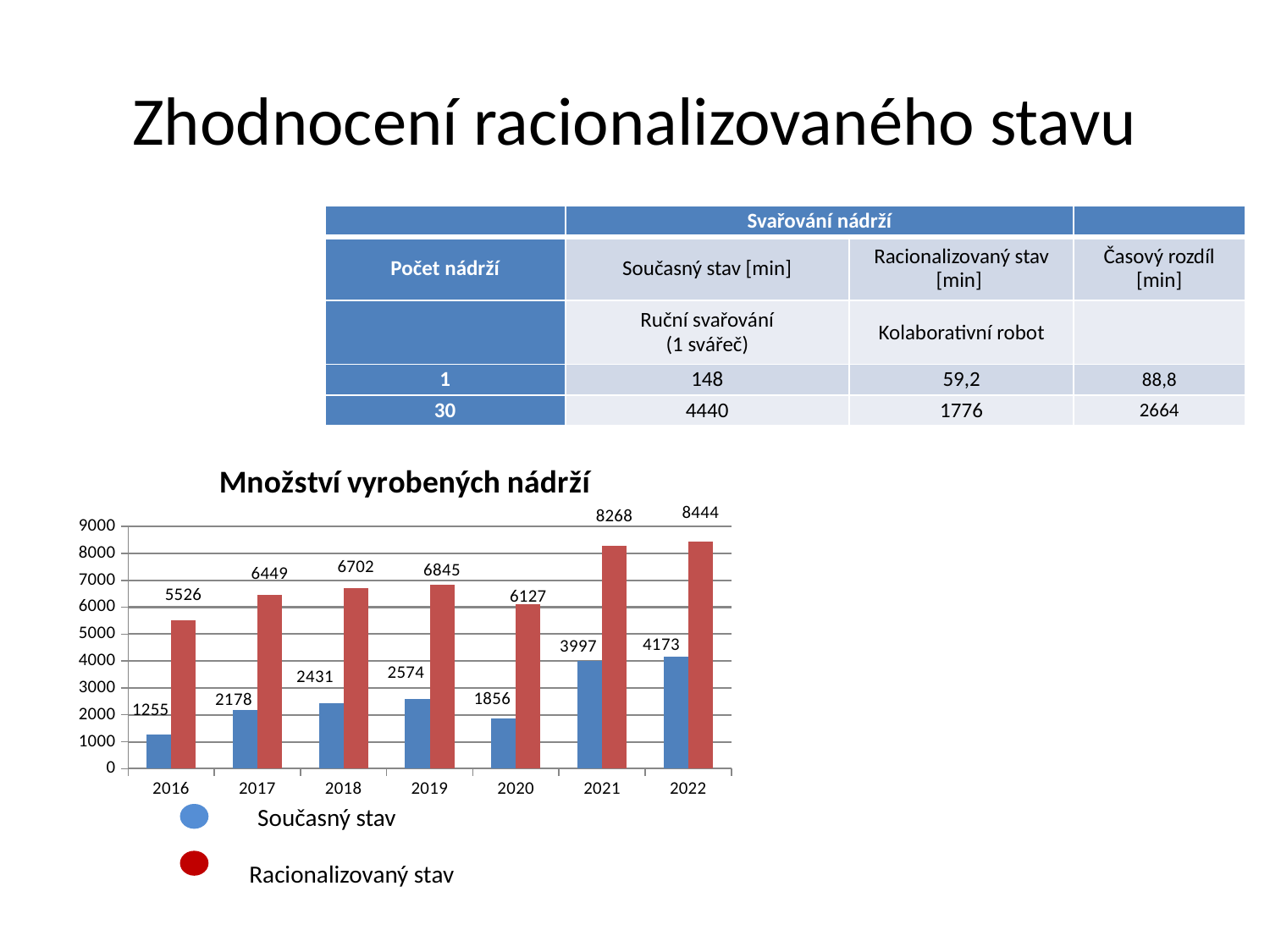
What is the value of Racionalizovaný stav for 2022? 8444 How many series does the legend list? 2 What is the title of the chart? Množství vyrobených nádrží In which year is Racionalizovaný stav lowest? 2016 What is the difference between Racionalizovaný stav and Současný stav in 2021? 4271 Which is larger: Současný stav in 2019 or Současný stav in 2020? Současný stav in 2019 Is the value of Racionalizovaný stav for 2018 greater or less than 6000? greater What is the value of Současný stav for 2016? 1255 In which year is Současný stav highest? 2022 What is the value of Racionalizovaný stav for 2020? 6127 What kind of chart is shown on the slide? bar chart How many years are shown on the x axis? 7